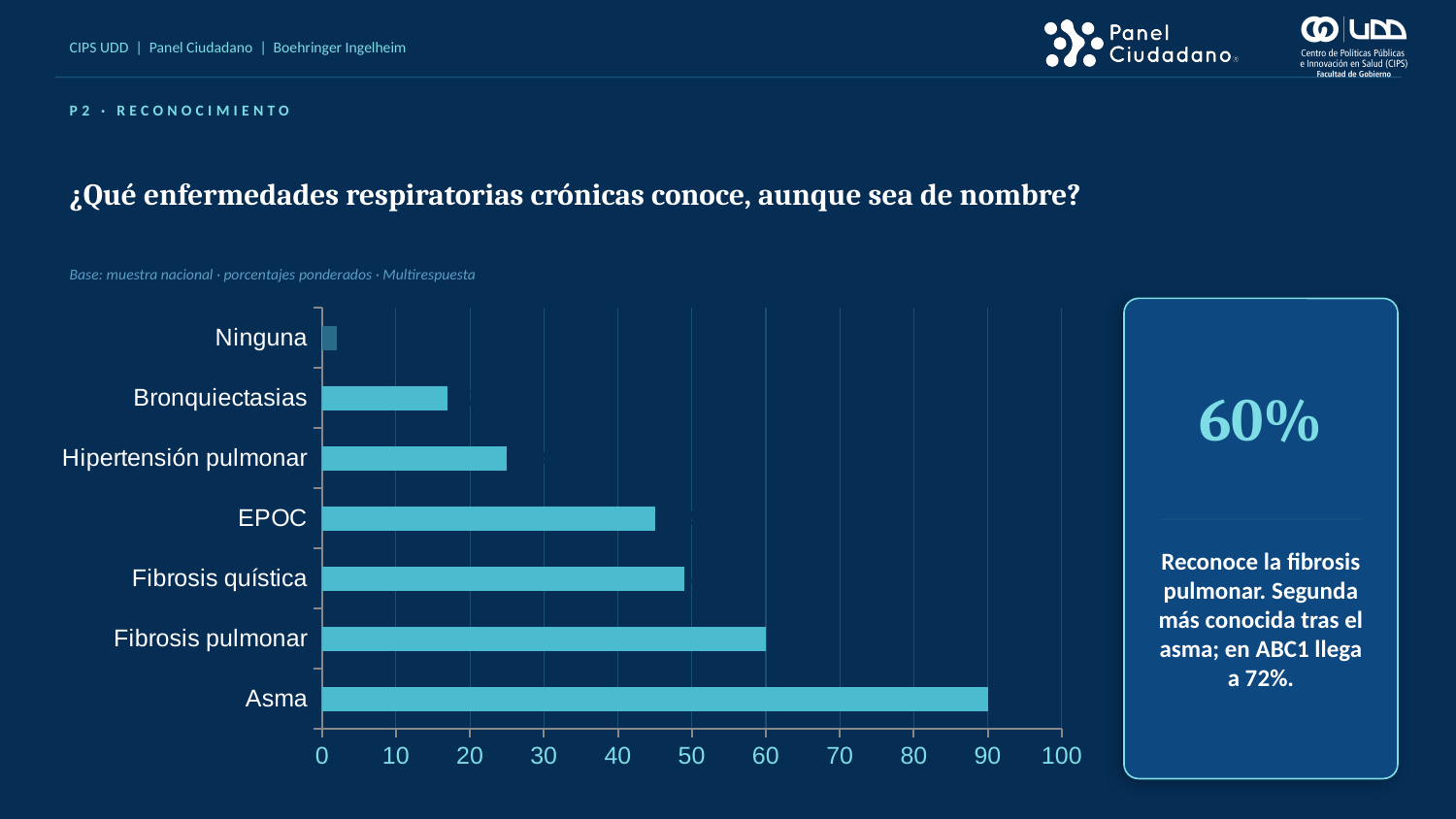
What kind of chart is shown on the slide? Bar chart What is the title of the chart on the slide? ¿Qué enfermedades respiratorias crónicas conoce, aunque sea de nombre? Which category has the highest value in the chart? Asma Which category has the lowest value in the chart? Ninguna Is the value for Bronquiectasias greater or less than 20? less Is the value for Asma greater or less than 80? greater Is the value for Ninguna greater or less than 10? less How many categories (diseases/options) are plotted in the chart? 7 Which has a larger value, Hipertensión pulmonar or Bronquiectasias? Hipertensión pulmonar What percentage of respondents recognise Fibrosis pulmonar? 60%